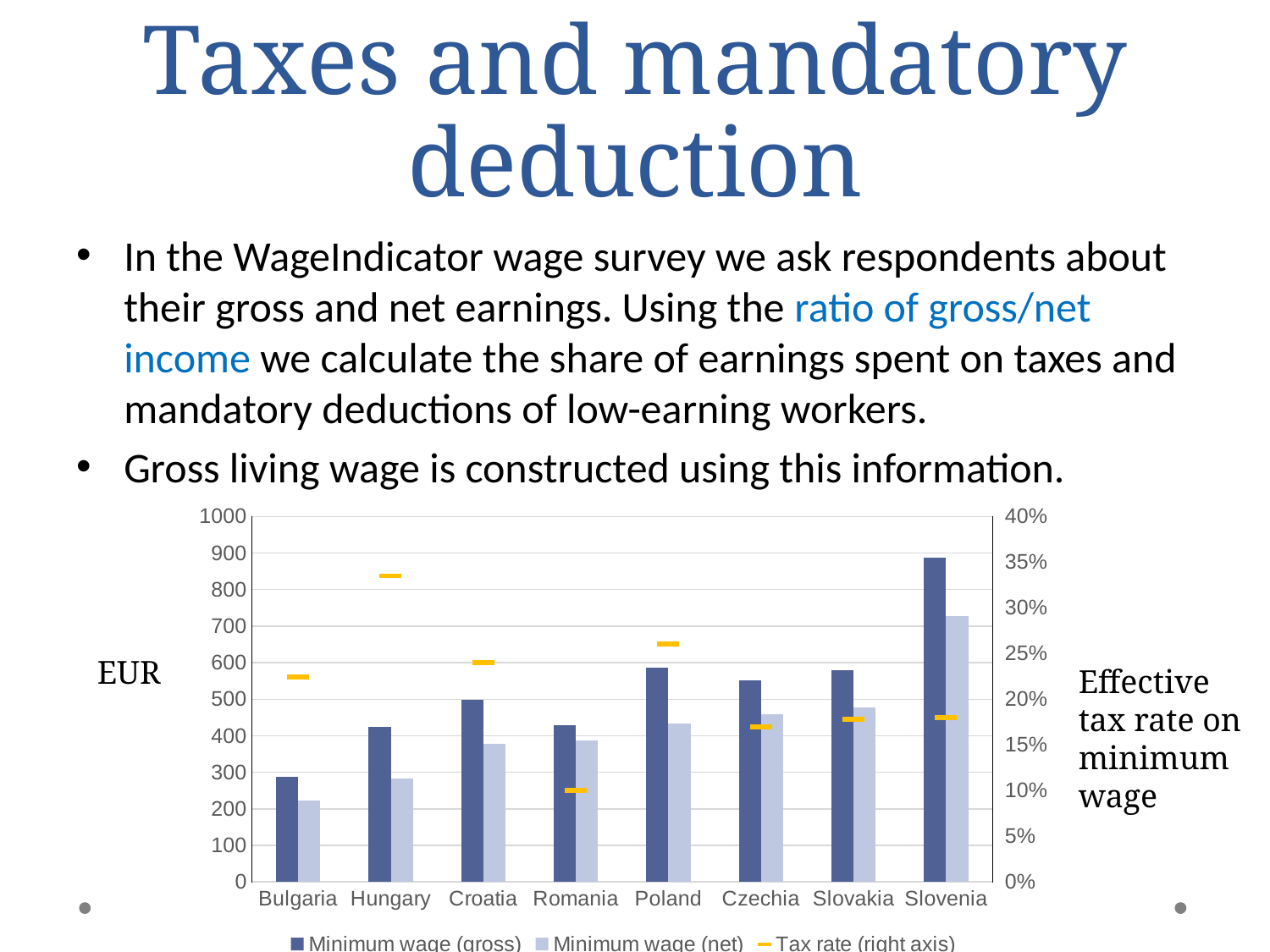
Which country has the lowest gross minimum wage in the chart? Bulgaria Is the tax rate for Hungary greater or less than 30%? greater Which country has the highest effective tax rate on minimum wage in the chart? Hungary What type of chart is shown on the slide? bar chart How many countries are shown on the x axis of the chart? 8 What unit is labelled on the left vertical axis of the chart? EUR Is the net minimum wage for Bulgaria greater or less than 300 EUR? less Which is larger: the net minimum wage for Slovenia or the gross minimum wage for Poland? Net minimum wage for Slovenia Which country has the highest gross minimum wage in the chart? Slovenia How many series does the chart legend list? 3 Which country has the lowest effective tax rate on minimum wage in the chart? Romania Is the gross minimum wage for Slovenia greater or less than 800 EUR? greater